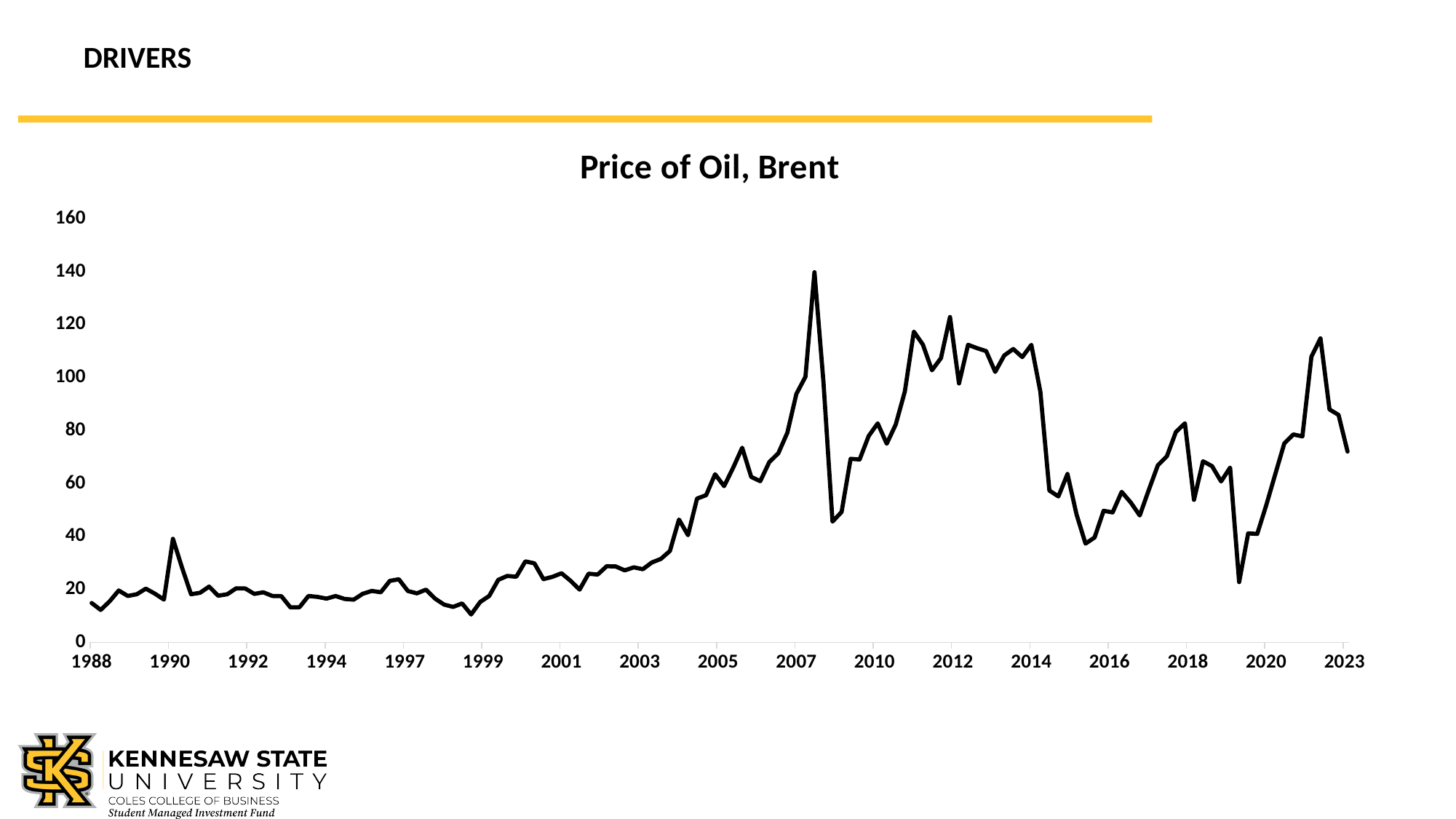
Is the peak value of the line greater or less than 120? greater Does the price of oil generally rise or fall between 1999 and 2007? rise Is the value for 1988 greater or less than 20? less Which year has the larger value, 1992 or 2012? 2012 Is the value for 2005 greater or less than 40? greater What kind of chart is shown on the slide? line chart What is the title of the chart? Price of Oil, Brent What is the highest value shown on the vertical axis? 160 Does the price of oil generally rise or fall between 2012 and 2016? fall